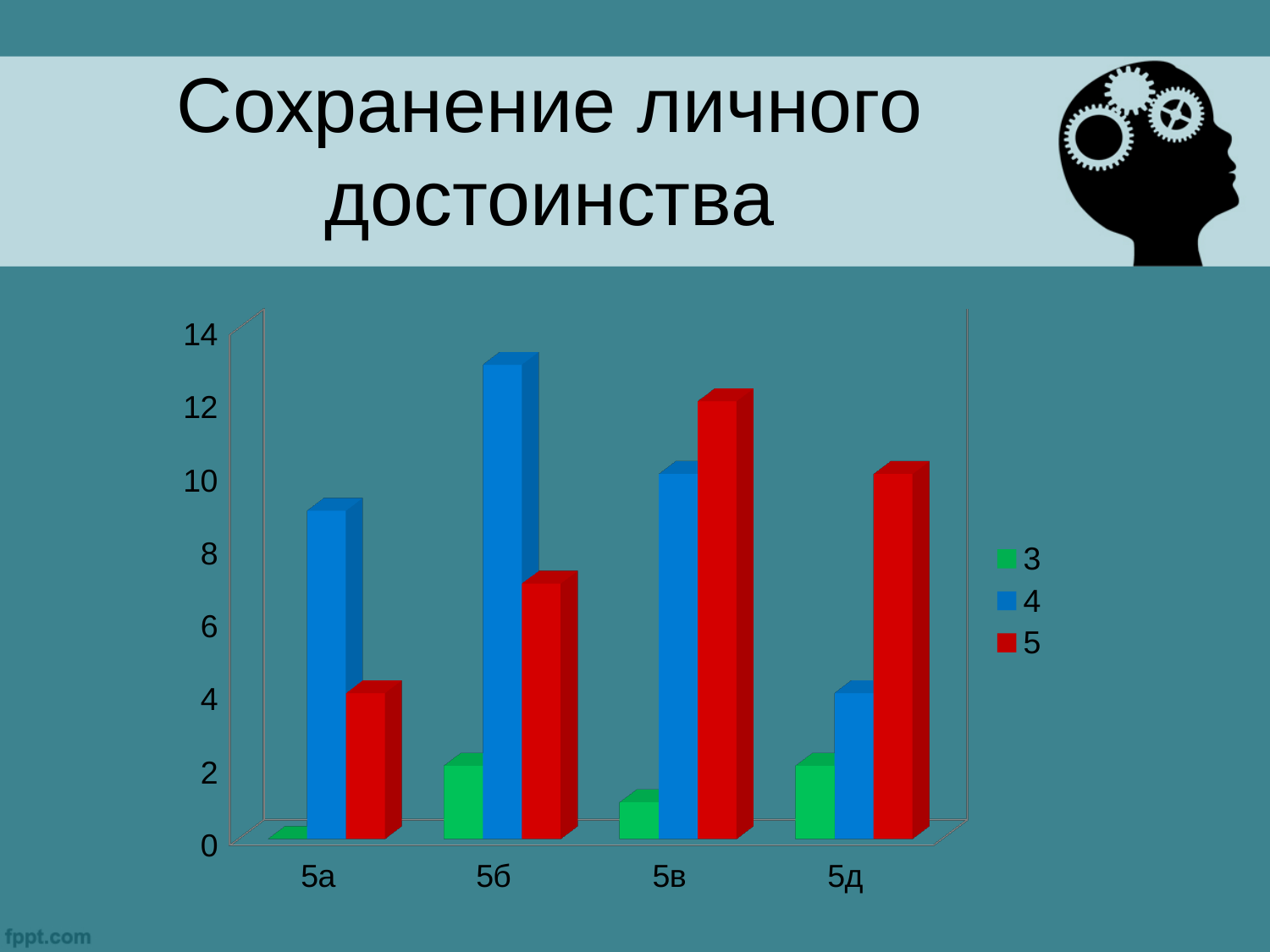
How many categories are shown on the x axis of the chart? 4 Is the value for series 4 in category 5б greater or less than 12? greater What are the entries in the chart's legend? 3, 4, 5 Is the value for series 5 in category 5б greater or less than 6? greater Which category has the lowest bar for series 4? 5д Is the value for series 5 in category 5а greater or less than 6? less Which category has the highest bar for series 4? 5б How many series does the chart's legend list? 3 What kind of chart is shown on the slide? bar chart Which category has the highest bar for series 5? 5в For series 5, which category has the larger value, 5в or 5д? 5в For category 5а, which series has the larger value, 4 or 5? 4